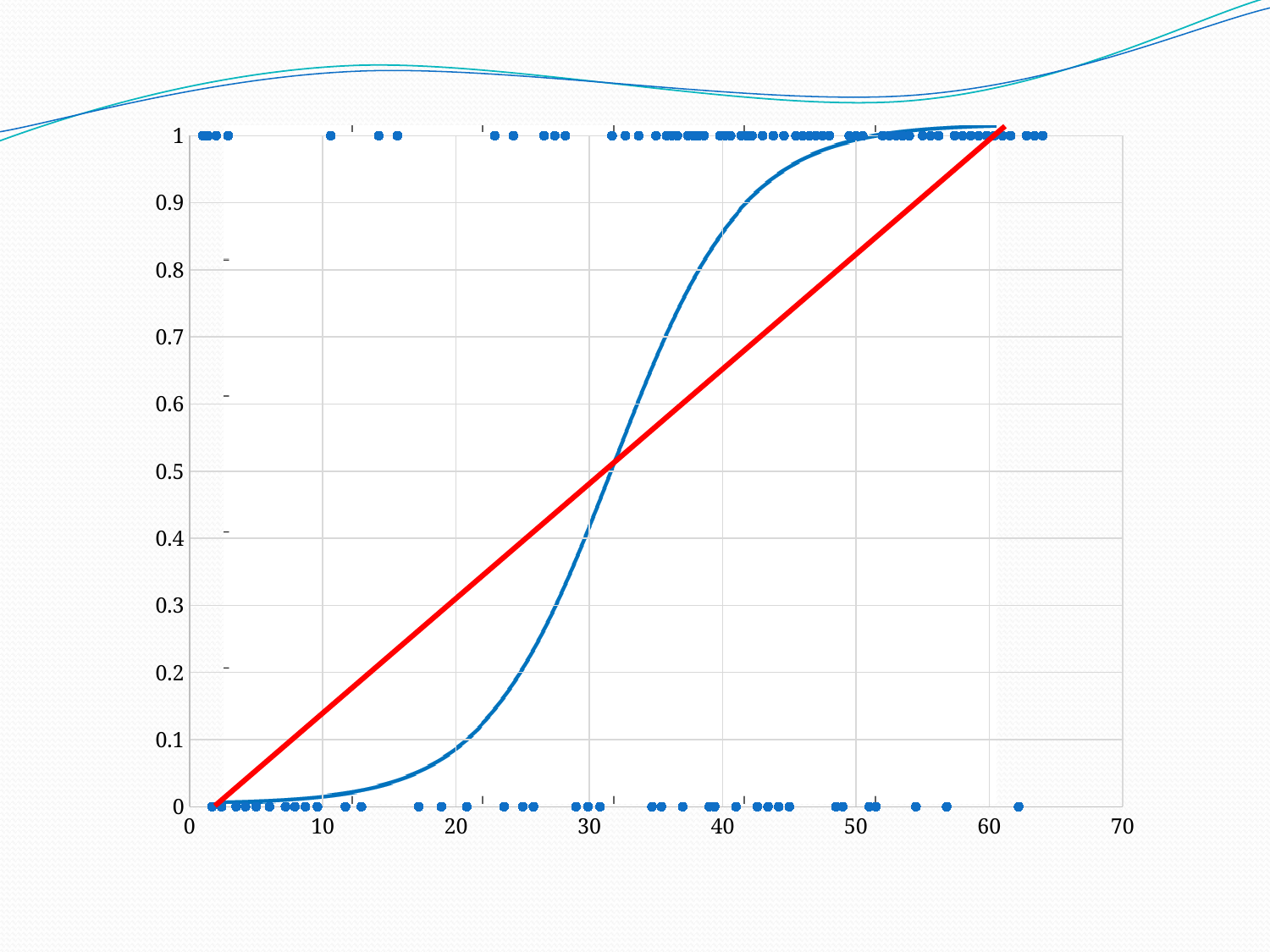
What is the highest value labelled on the x axis? 70 Is the value of the blue curve at x = 40 greater or less than 0.5? greater Is the value of the blue curve at x = 50 greater or less than 0.9? greater Is the value of the blue curve at x = 10 greater or less than 0.1? less At x = 40, which is higher: the blue curve or the red line? the blue curve What kind of chart is shown on the slide? scatter chart Does the blue S-shaped curve rise or fall as x increases from 0 to 60? rise At x = 20, which is higher: the blue curve or the red line? the red line Does the red straight line rise or fall as x increases? rise